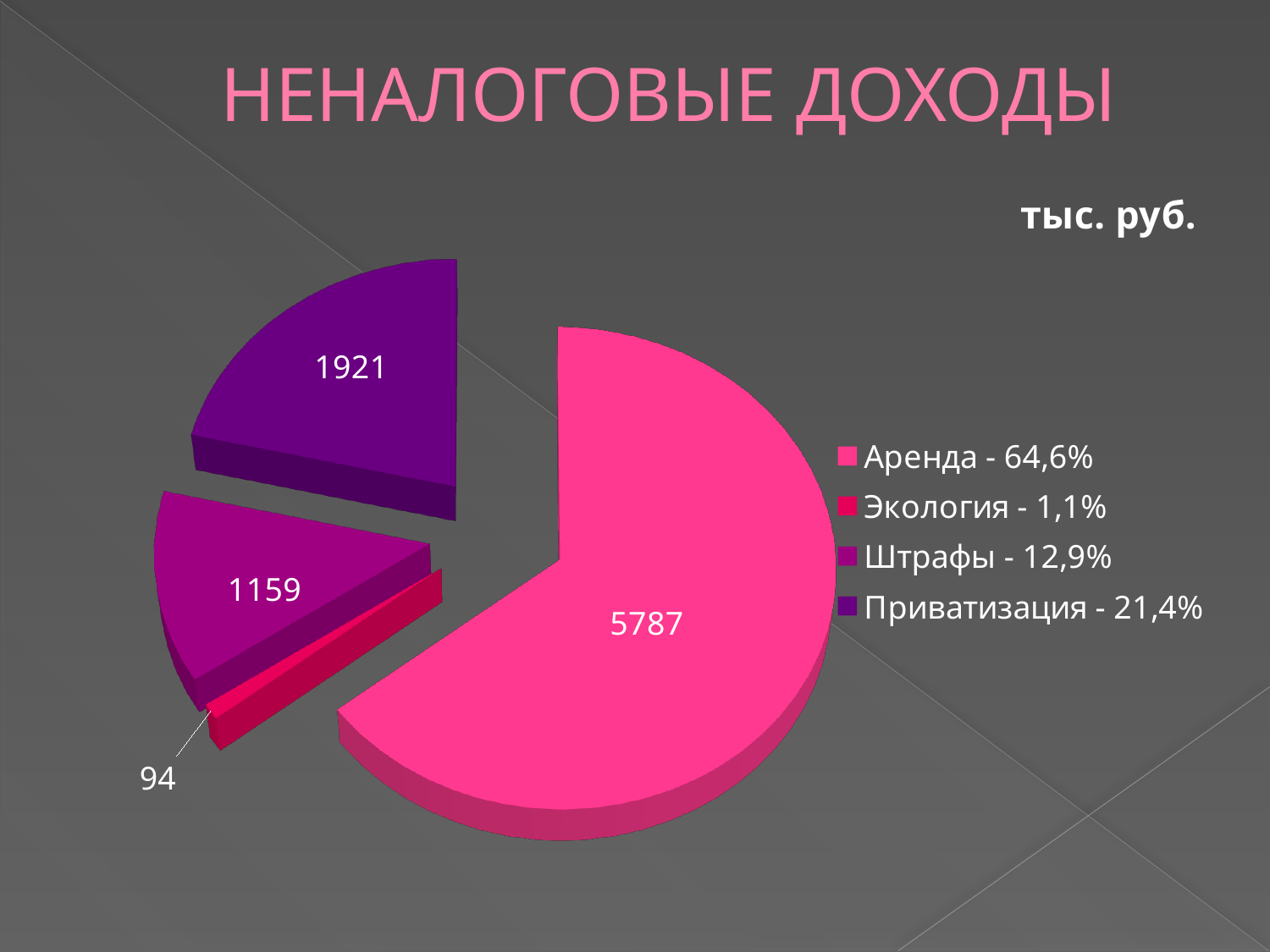
What is the difference between the values for Приватизация and Штрафы? 762 Which is larger, the value for Штрафы or the value for Приватизация? Приватизация How many categories does the pie chart have? 4 What kind of chart is shown on the slide? pie chart What is the value for Приватизация? 1921 What is the title of the chart? тыс. руб. Which category has the smallest slice? Экология What share of the pie does Штрафы represent, according to the legend? 12,9% What is the value for Штрафы? 1159 Which category has the largest slice? Аренда What is the value for Экология? 94 What is the value for Аренда? 5787